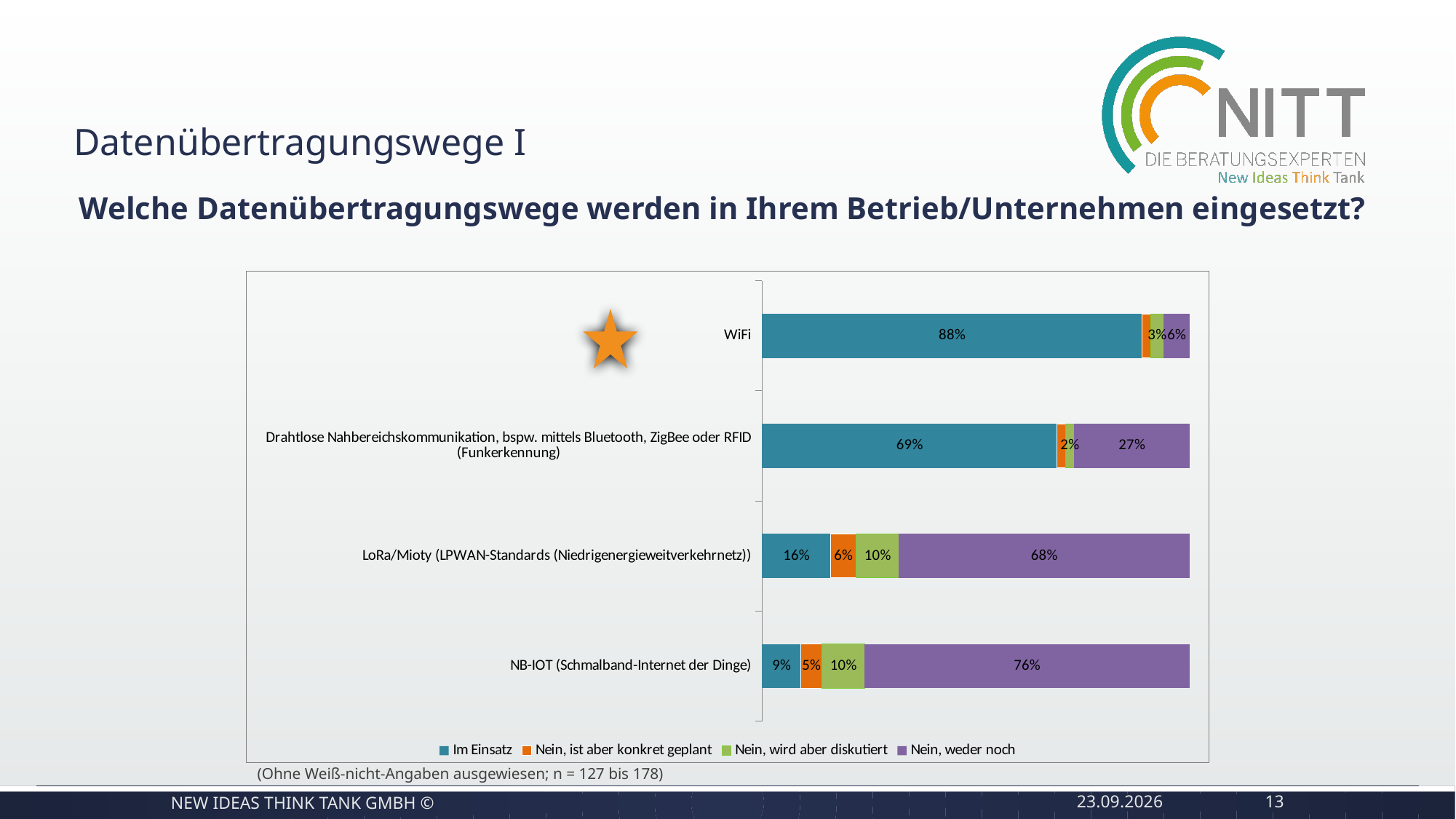
What is the 'Nein, ist aber konkret geplant' value for LoRa/Mioty (LPWAN-Standards)? 6% Which category has the lowest 'Im Einsatz' value? NB-IOT (Schmalband-Internet der Dinge) Which legend entry is shown in purple? Nein, weder noch Which category has the highest 'Im Einsatz' value? WiFi How many categories (data transmission methods) are shown in the chart? 4 What is the 'Nein, weder noch' value for Drahtlose Nahbereichskommunikation (Funkerkennung)? 27% What kind of chart is shown on the slide? stacked bar chart How many series does the legend list? 4 What is the 'Nein, weder noch' value for NB-IOT (Schmalband-Internet der Dinge)? 76% What is the 'Im Einsatz' value for WiFi? 88% What is the difference between the 'Im Einsatz' values for WiFi and Drahtlose Nahbereichskommunikation? 19% Which is larger: the 'Nein, weder noch' value for LoRa/Mioty or for NB-IOT? NB-IOT